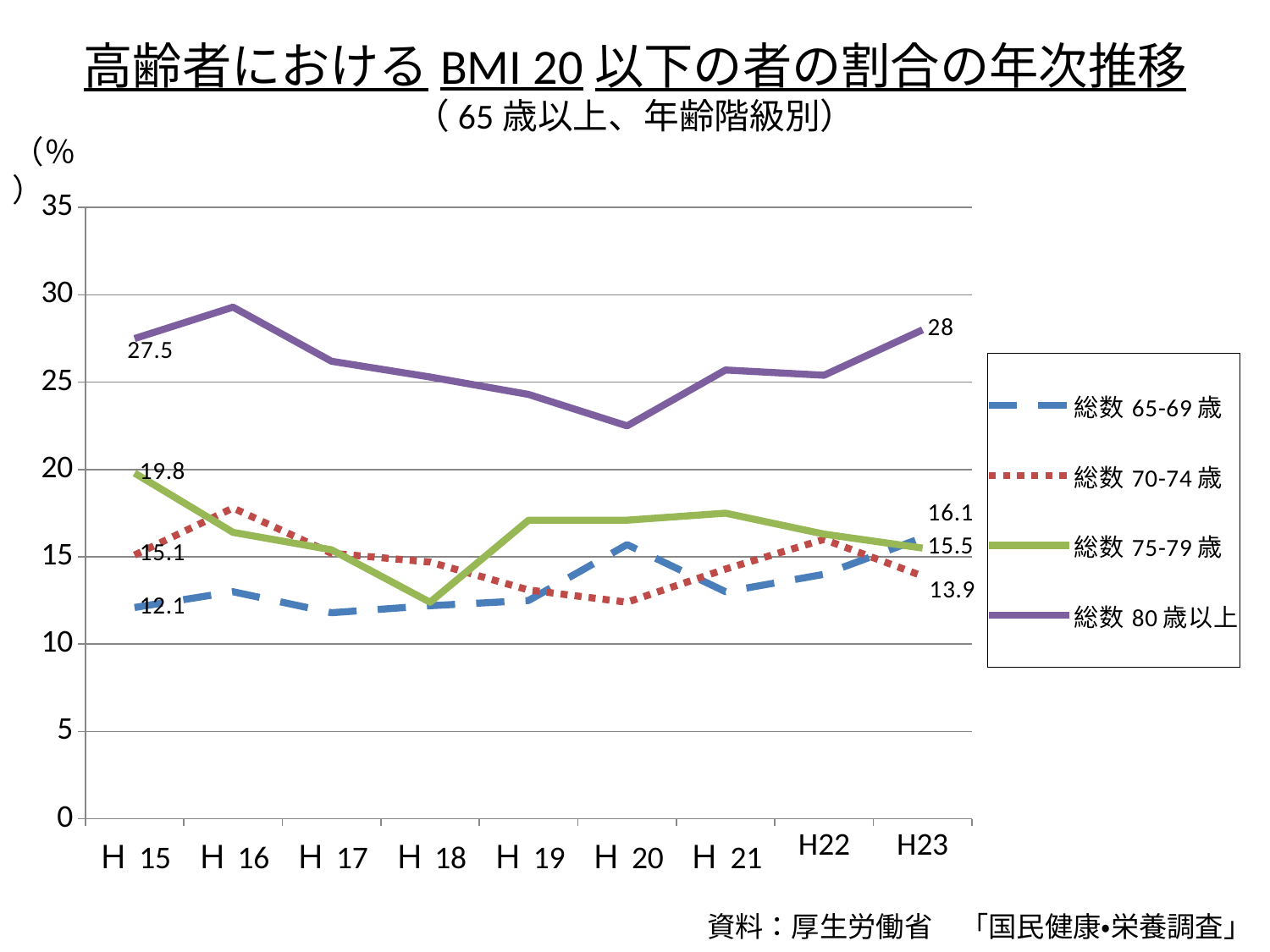
Which is larger in H15: the value for 総数 70-74歳 or 総数 65-69歳? 総数 70-74歳 What is the value for 総数 80歳以上 in H15? 27.5 Which series has the lowest value in H15? 総数 65-69歳 What is the difference between the 総数 80歳以上 value in H23 and in H15? 0.5 How many years (x-axis points) are plotted on the chart? 9 How many series does the legend list? 4 What type of chart is shown on the slide? line chart Is the value for 総数 80歳以上 in H20 greater or less than 25? less What is the value for 総数 70-74歳 in H23? 13.9 What is the value for 総数 65-69歳 in H23? 16.1 Which series has the highest value in H23? 総数 80歳以上 What is the value for 総数 75-79歳 in H15? 19.8